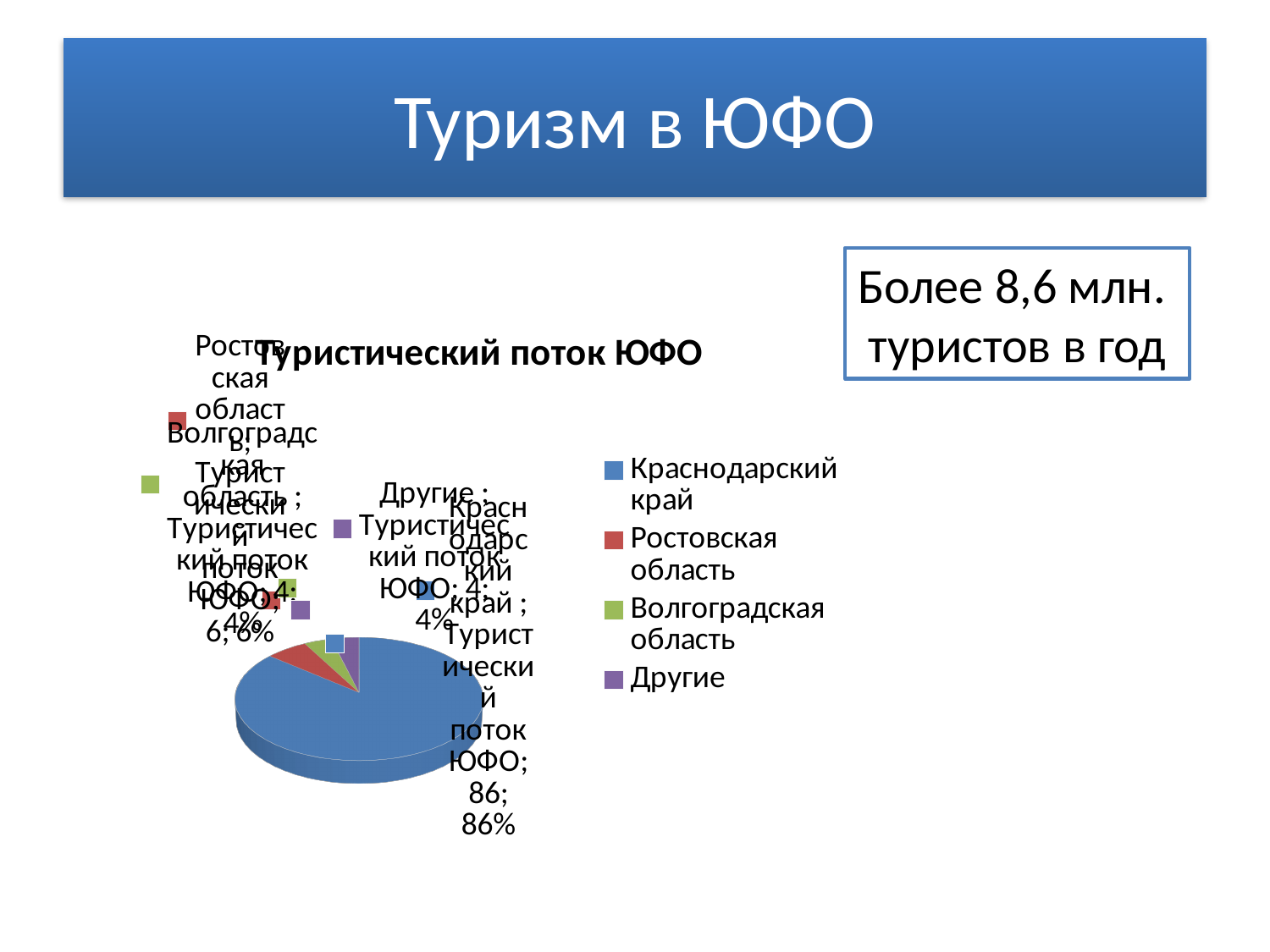
What is the title of the chart? Туристический поток ЮФО Which category has the largest slice of the pie? Краснодарский край Which colour represents Краснодарский край in the pie chart? blue Which is larger, the slice for Ростовская область or the slice for Волгоградская область? Ростовская область What share of the pie does Ростовская область have? 6% What share of the pie does Волгоградская область have? 4% What is the difference in percentage points between the shares of Краснодарский край and Ростовская область? 80 What is the combined share of Ростовская область, Волгоградская область and Другие? 14% How many categories does the legend of the pie chart list? 4 What kind of chart is shown on the slide? pie chart What share of the pie does Краснодарский край have? 86%